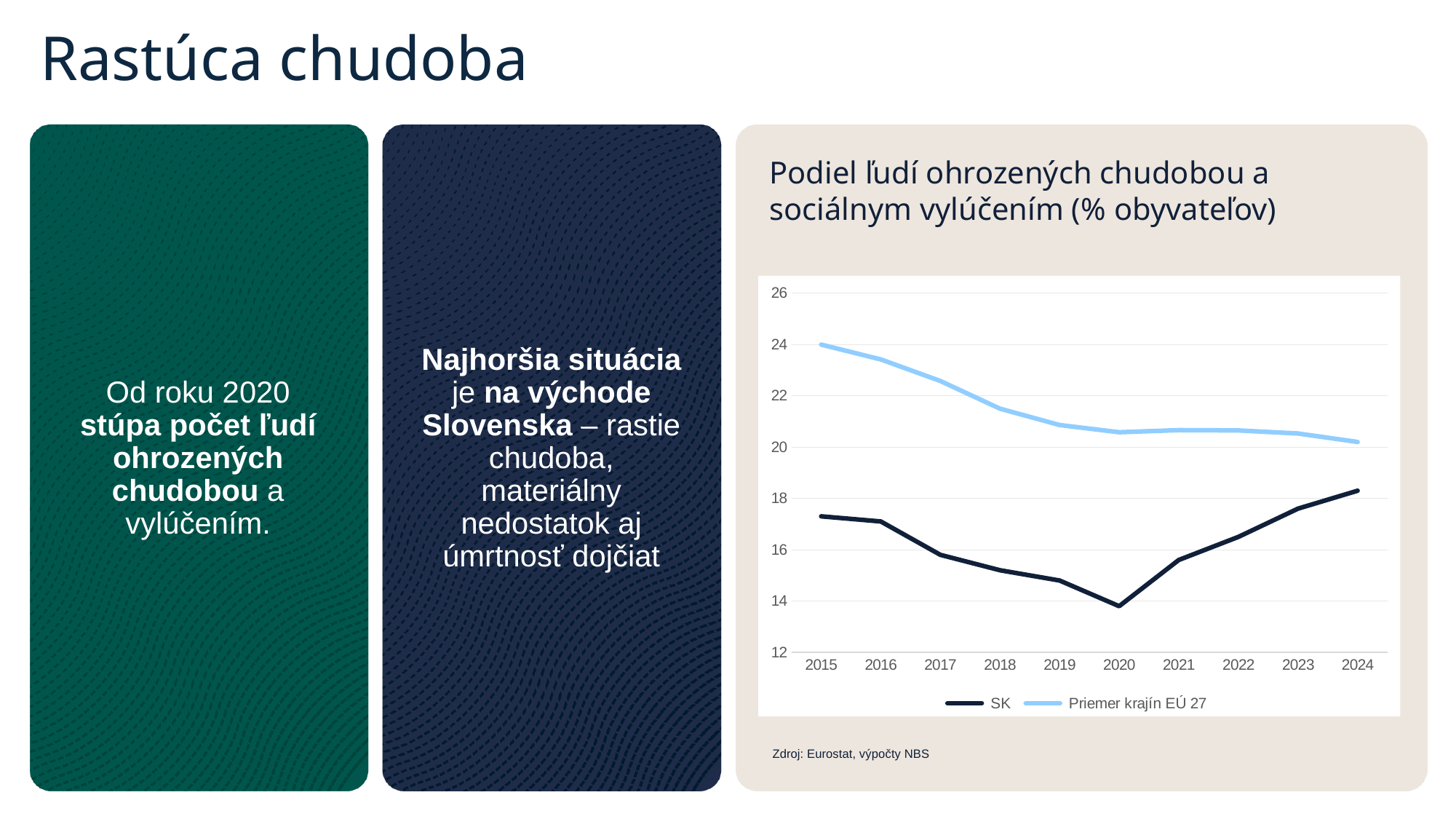
Is the value for SK in 2020 greater or less than 16? less Is the value for Priemer krajín EÚ 27 in 2015 greater or less than 22? greater What kind of chart is shown on the slide? line chart In which year is the SK series at its highest? 2024 Does the SK series rise or fall between 2020 and 2024? rise Is the value for SK in 2015 greater or less than 18? less Which series has the higher value in 2024, SK or Priemer krajín EÚ 27? Priemer krajín EÚ 27 What is the title of the chart? Podiel ľudí ohrozených chudobou a sociálnym vylúčením (% obyvateľov) How many years are shown on the x axis of the chart? 10 In which year is the SK series at its lowest? 2020 In which year is the Priemer krajín EÚ 27 series at its highest? 2015 How many series does the chart legend list? 2